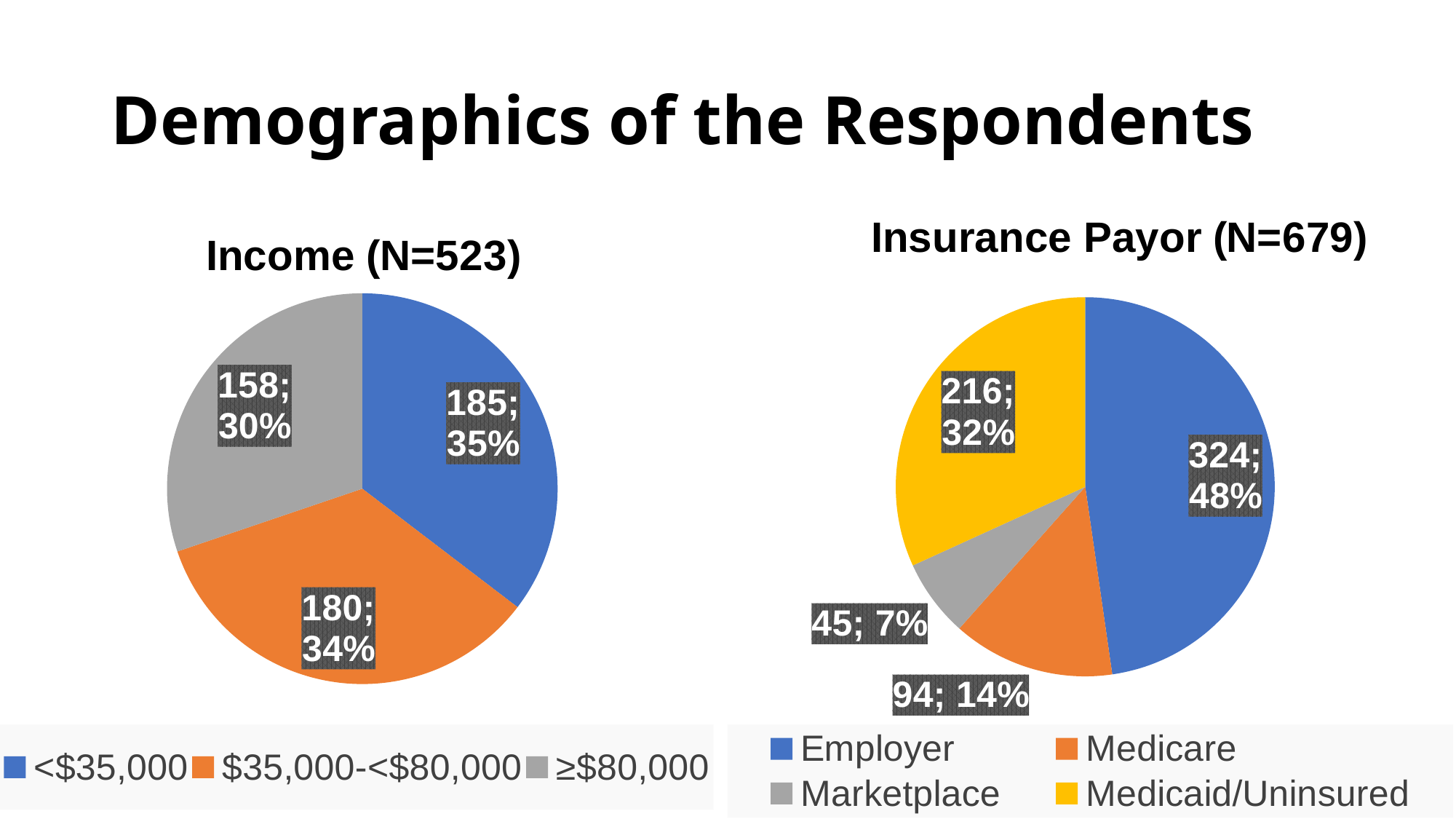
In the Income (N=523) chart, how many income categories are shown? 3 In the Insurance Payor (N=679) chart, what share of respondents are Medicaid/Uninsured? 32% In the Insurance Payor (N=679) chart, which payor category is the smallest? Marketplace In the Income (N=523) chart, what is the difference in respondent count between the <$35,000 and ≥$80,000 categories? 27 In the Income (N=523) chart, what percentage of respondents reported income of ≥$80,000? 30% In the Insurance Payor (N=679) chart, which payor category is the largest? Employer What type of chart is used for the Insurance Payor (N=679) data? Pie chart In the Insurance Payor (N=679) chart, what is the difference in respondent count between Employer and Medicaid/Uninsured? 108 In the Insurance Payor (N=679) chart, which has more respondents, Medicare or Marketplace? Medicare In the Income (N=523) chart, how many respondents reported income of <$35,000? 185 In the Income (N=523) chart, which income category has the fewest respondents? ≥$80,000 In the Insurance Payor (N=679) chart, how many respondents have Employer insurance? 324